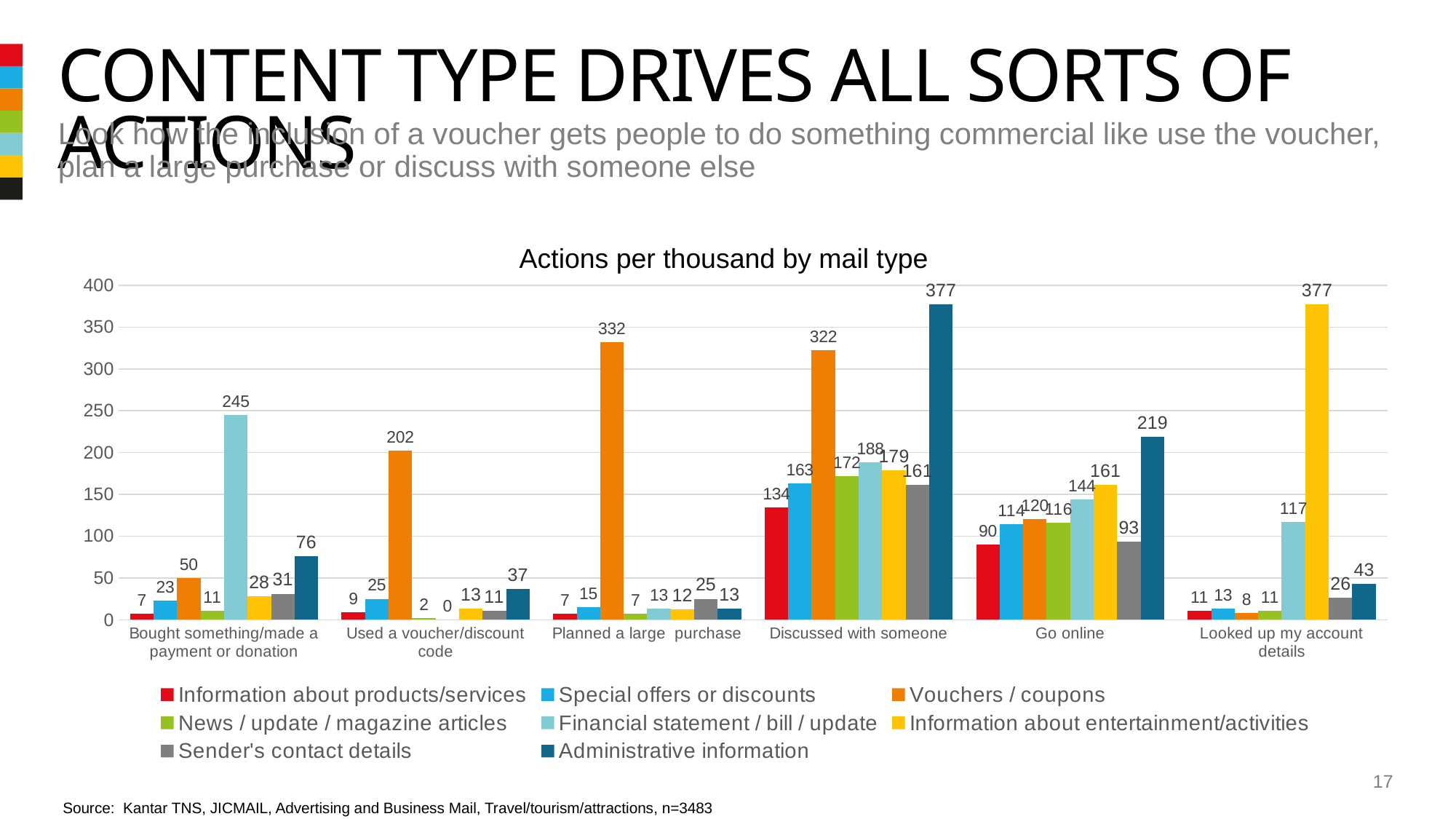
What is the difference between Administrative information and Vouchers / coupons in the Discussed with someone category? 55 What is the value for Vouchers / coupons in the Used a voucher/discount code category? 202 What kind of chart is shown on the slide? Bar chart What is the title of the chart? Actions per thousand by mail type What is the value for Financial statement / bill / update in the Bought something/made a payment or donation category? 245 How many action categories are shown on the x axis? 6 Which mail type has the highest value in the Discussed with someone category? Administrative information Which mail type has the lowest value in the Used a voucher/discount code category? Financial statement / bill / update How many series does the legend list? 8 In the Go online category, which is larger: Administrative information or Information about entertainment/activities? Administrative information What is the value for Information about entertainment/activities in the Looked up my account details category? 377 What is the value for Vouchers / coupons in the Planned a large purchase category? 332